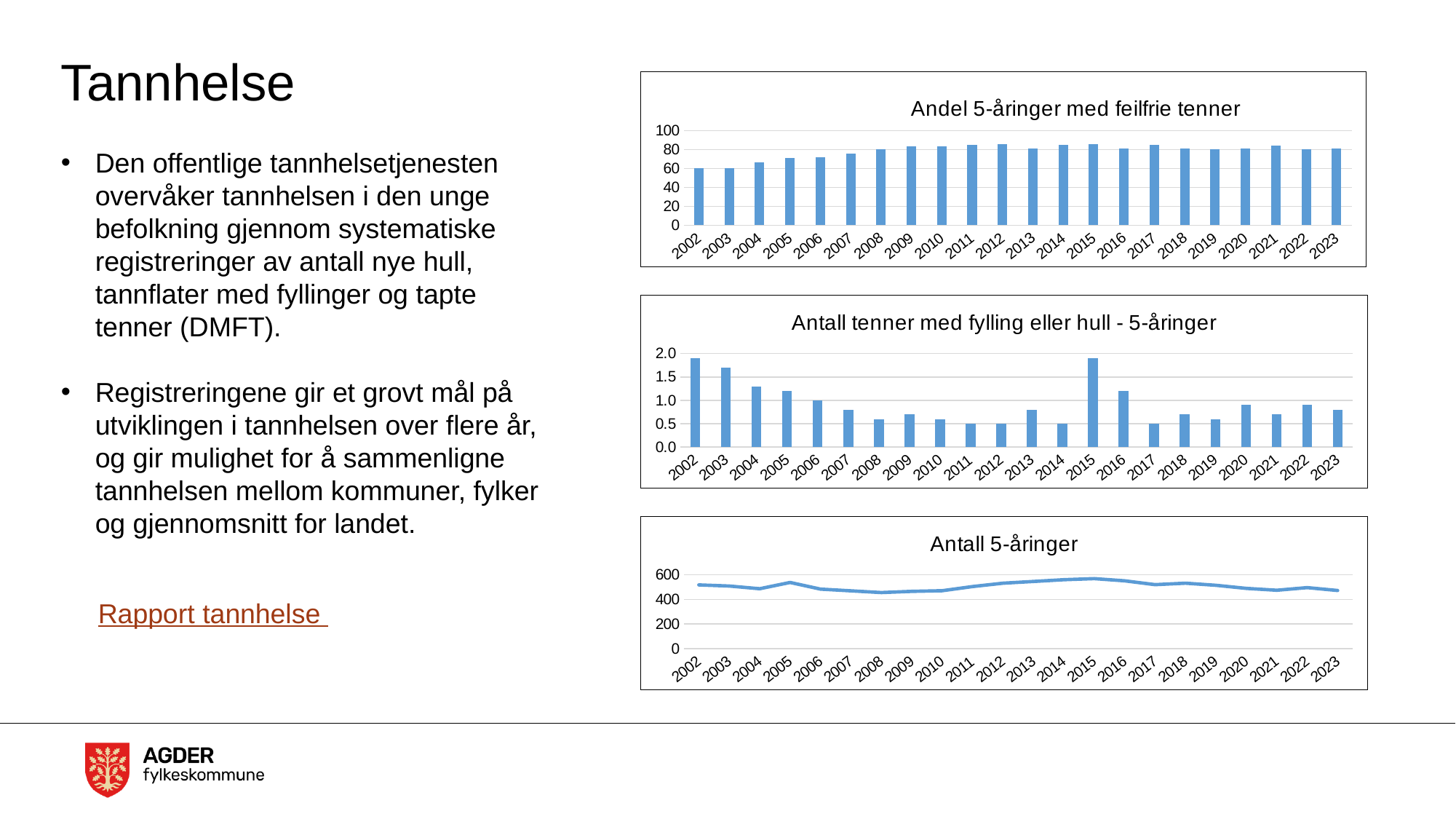
How many charts are shown on the slide? 3 In the chart titled 'Antall tenner med fylling eller hull - 5-åringer', do the values rise or fall from 2002 to 2008? fall In the chart titled 'Andel 5-åringer med feilfrie tenner', which year has the larger value, 2002 or 2015? 2015 In the chart titled 'Antall tenner med fylling eller hull - 5-åringer', is the value for 2008 greater or less than 1.0? less In the chart titled 'Antall 5-åringer', is the value for 2015 greater or less than 400? greater What kind of chart is the chart titled 'Antall 5-åringer'? line chart How many years are shown on the x axis of the chart titled 'Antall tenner med fylling eller hull - 5-åringer'? 22 What kind of chart is the chart titled 'Andel 5-åringer med feilfrie tenner'? bar chart In the chart titled 'Andel 5-åringer med feilfrie tenner', is the value for 2002 greater or less than 80? less In the chart titled 'Antall tenner med fylling eller hull - 5-åringer', which year has the larger value, 2002 or 2010? 2002